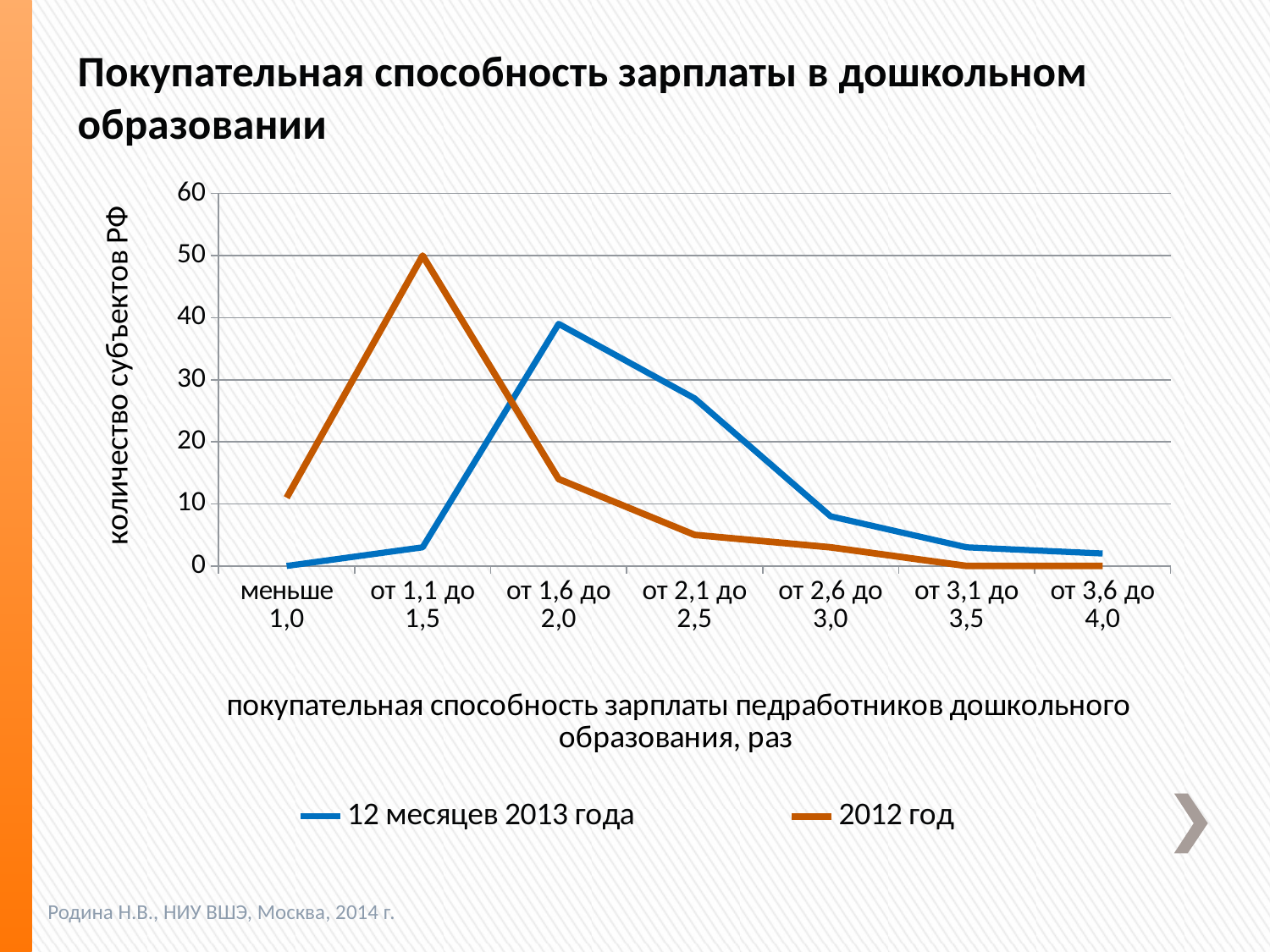
What kind of chart is shown on the slide? line chart Is the value for "12 месяцев 2013 года" in the category "от 2,1 до 2,5" greater or less than 20? greater How many series does the legend list? 2 What is the value of the series "12 месяцев 2013 года" for the category "меньше 1,0"? 0 In which category does the series "2012 год" reach its highest value? от 1,1 до 1,5 How many categories are shown on the x axis? 7 Does the series "12 месяцев 2013 года" rise or fall from "от 1,6 до 2,0" to "от 3,6 до 4,0"? fall Is the value for "2012 год" in the category "от 1,6 до 2,0" greater or less than 20? less In which category does the series "12 месяцев 2013 года" reach its highest value? от 1,6 до 2,0 What is the value of the series "2012 год" for the category "от 1,1 до 1,5"? 50 What is the label of the vertical axis? количество субъектов РФ Which series has the larger value in the category "от 2,6 до 3,0"? 12 месяцев 2013 года